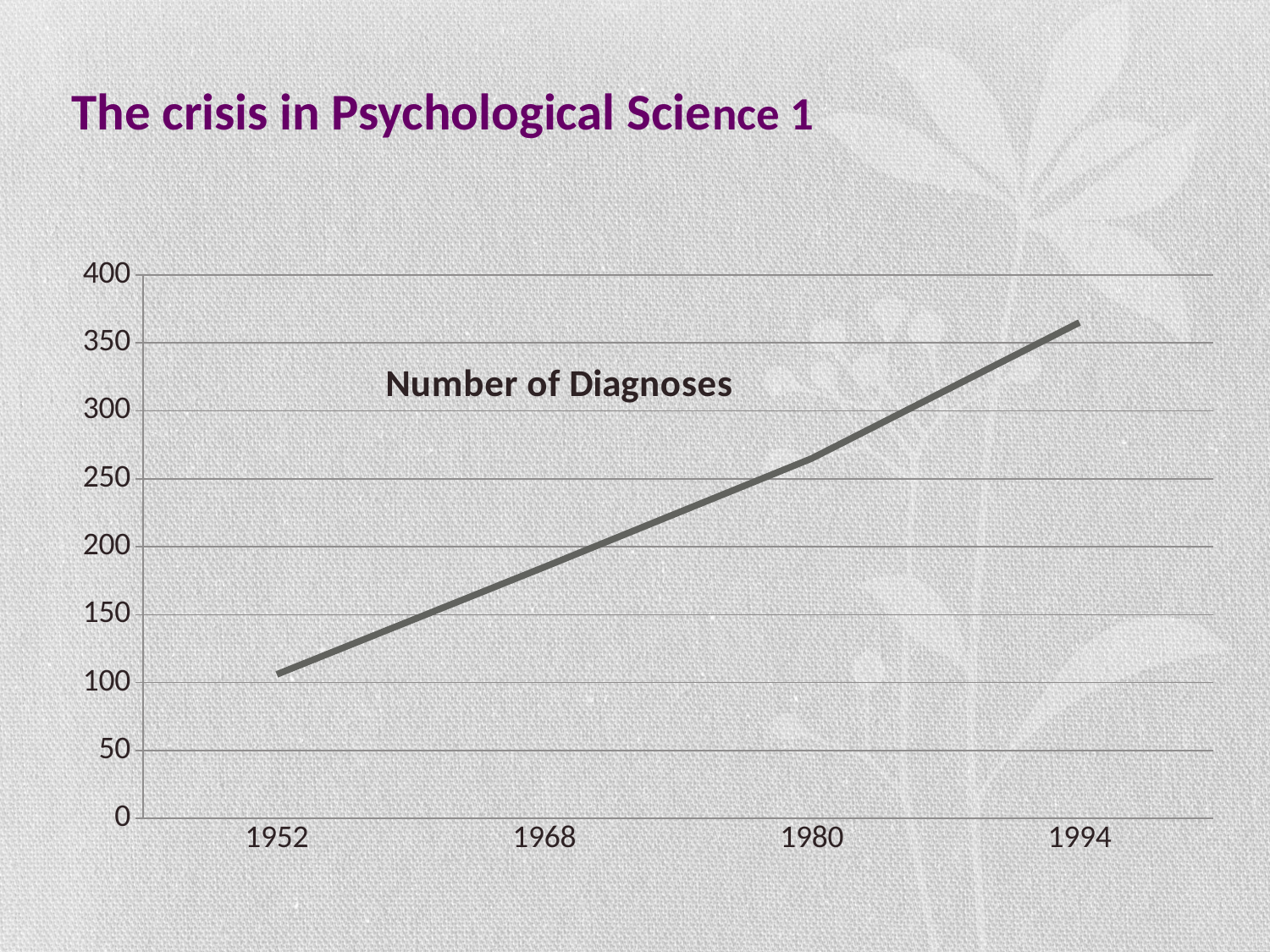
What is the title of the chart? Number of Diagnoses Which is larger, the value for 1980 or the value for 1968? 1980 How many years are plotted on the x axis of the chart? 4 What kind of chart is shown on the slide? line chart Which year has the highest number of diagnoses? 1994 Is the value for 1968 greater or less than 200? less Is the value for 1952 greater or less than 150? less Is the value for 1968 greater or less than 150? greater Do the values rise or fall from 1952 to 1994? rise Which year has the lowest number of diagnoses? 1952